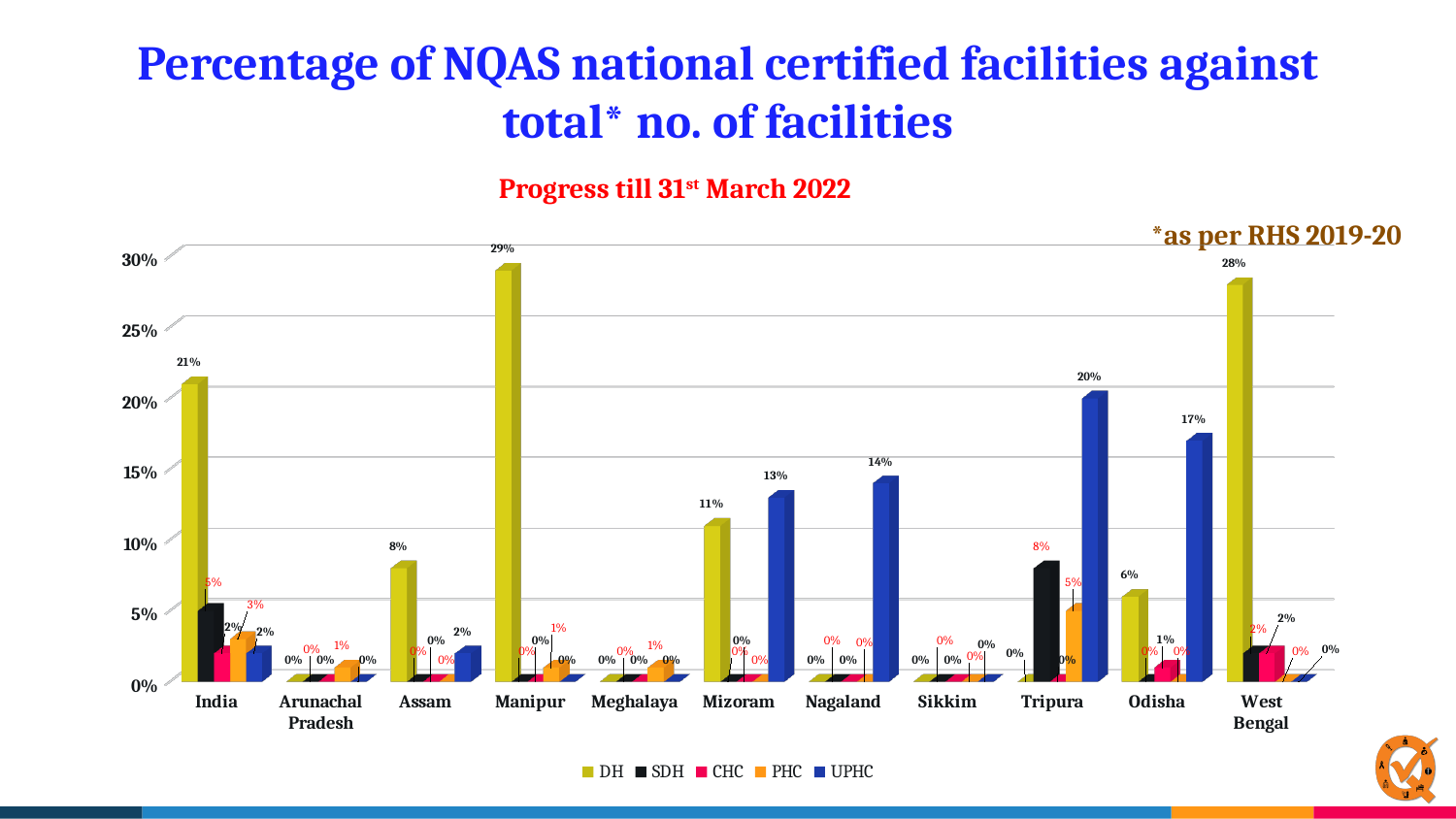
What is the DH value for India? 21% Which is larger for Mizoram, the DH value or the UPHC value? UPHC What kind of chart is shown on the slide? Bar chart What is the UPHC value for Odisha? 17% What is the DH value for Manipur? 29% How many states/regions are shown on the x axis? 11 What is the UPHC value for Tripura? 20% Which state has the highest UPHC value? Tripura What is the difference between the DH value for Manipur and the DH value for West Bengal? 1% Which state has the highest DH value? Manipur What is the SDH value for Tripura? 8% How many series does the legend list? 5